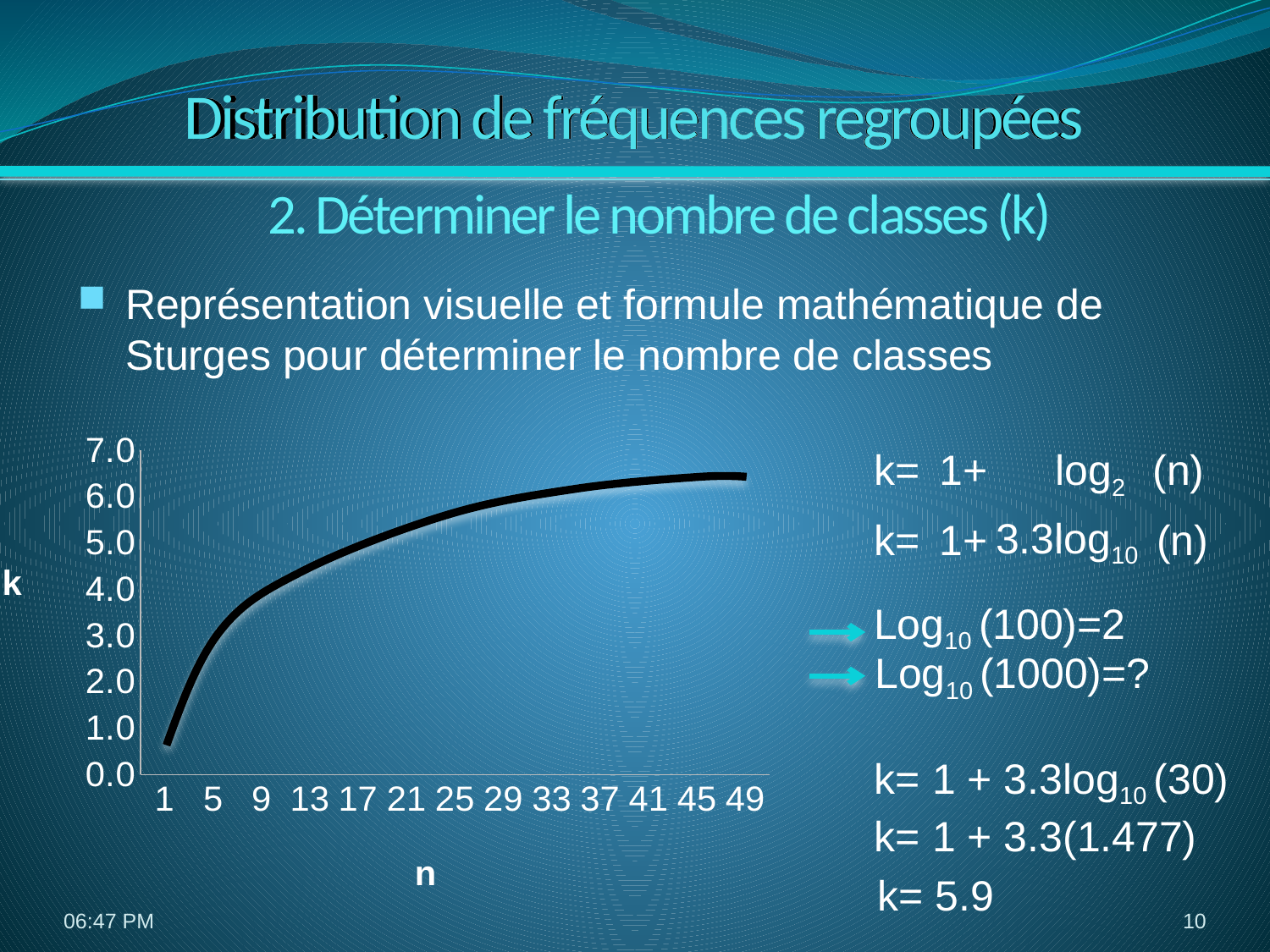
Is the value of k at n = 25 greater or less than 5.0? greater At which value of n is k highest on the chart? 49 Is the value of k at n = 49 larger than the value of k at n = 9? yes Is the value of k at n = 49 greater or less than 7.0? less Does the value of k rise or fall as n increases along the x axis? rise How many tick labels are shown on the x axis of the chart? 13 Is the value of k at n = 5 greater or less than 2.0? greater What kind of chart is shown on the slide? line chart What is the label of the vertical axis of the chart? k At which value of n is k lowest on the chart? 1